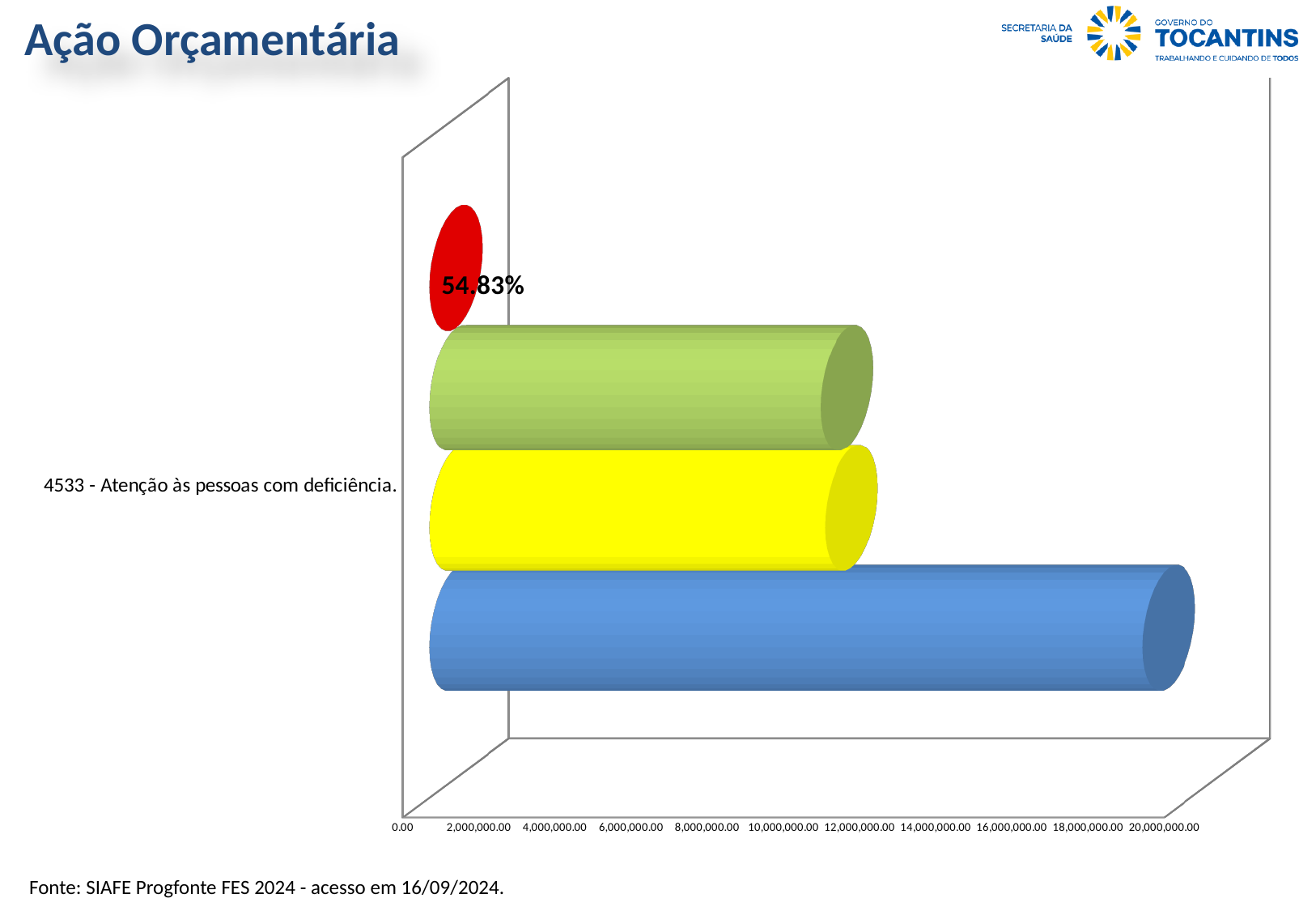
What is the title shown at the top of the slide? Ação Orçamentária What percentage is printed as a data label on the chart? 54.83% Which coloured bar is the shortest on the chart? the red bar Is the value of the blue bar greater or less than 16,000,000.00? greater Which coloured bar is the longest on the chart? the blue bar Is the value of the red bar greater or less than 2,000,000.00? less Is the value of the green bar greater or less than 8,000,000.00? greater How many bars are plotted on the chart? 4 How many categories are shown on the chart's vertical axis? 1 Which is larger, the value of the blue bar or the value of the yellow bar? the blue bar What kind of chart is shown on the slide? bar chart What is the category label shown on the chart? 4533 - Atenção às pessoas com deficiência.